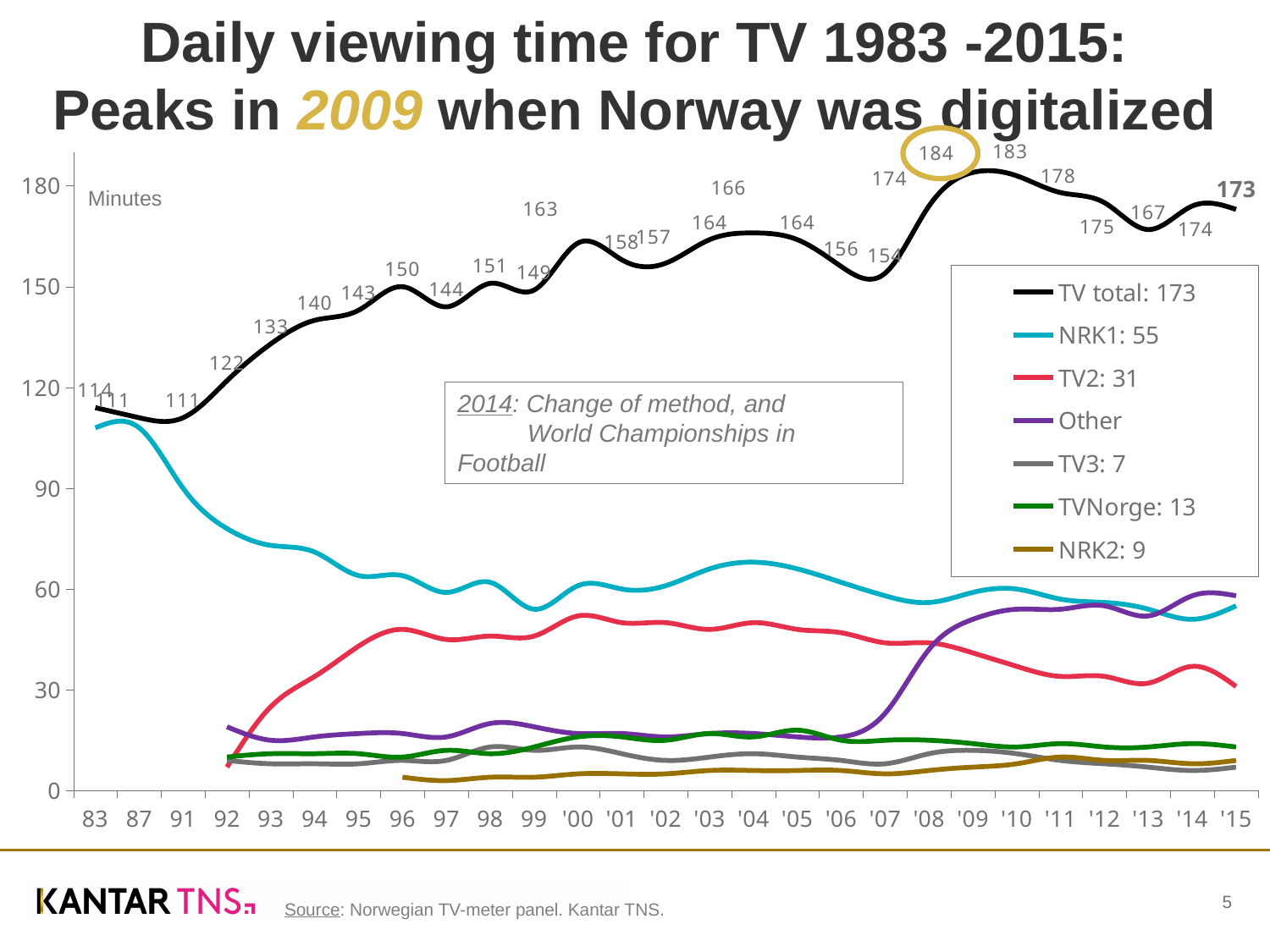
In which year does the TV total line reach its highest value? '09 How many series does the legend list? 7 What is the TV total daily viewing time in 1983? 114 What is the difference between the TV total in 2009 and in 2015? 11 Is the value for TV2 in 1996 greater or less than 30? greater Which year has a higher TV total value, 2000 or 2001? 2000 What kind of chart is shown on the slide? Line chart Does the TV total line rise or fall between 1992 and 1996? Rises Is the value for NRK1 in 1983 greater or less than 90? greater What is the lowest value shown on the TV total line? 111 What is the TV total daily viewing time in 2009? 184 What is the TV total daily viewing time in 2014? 174